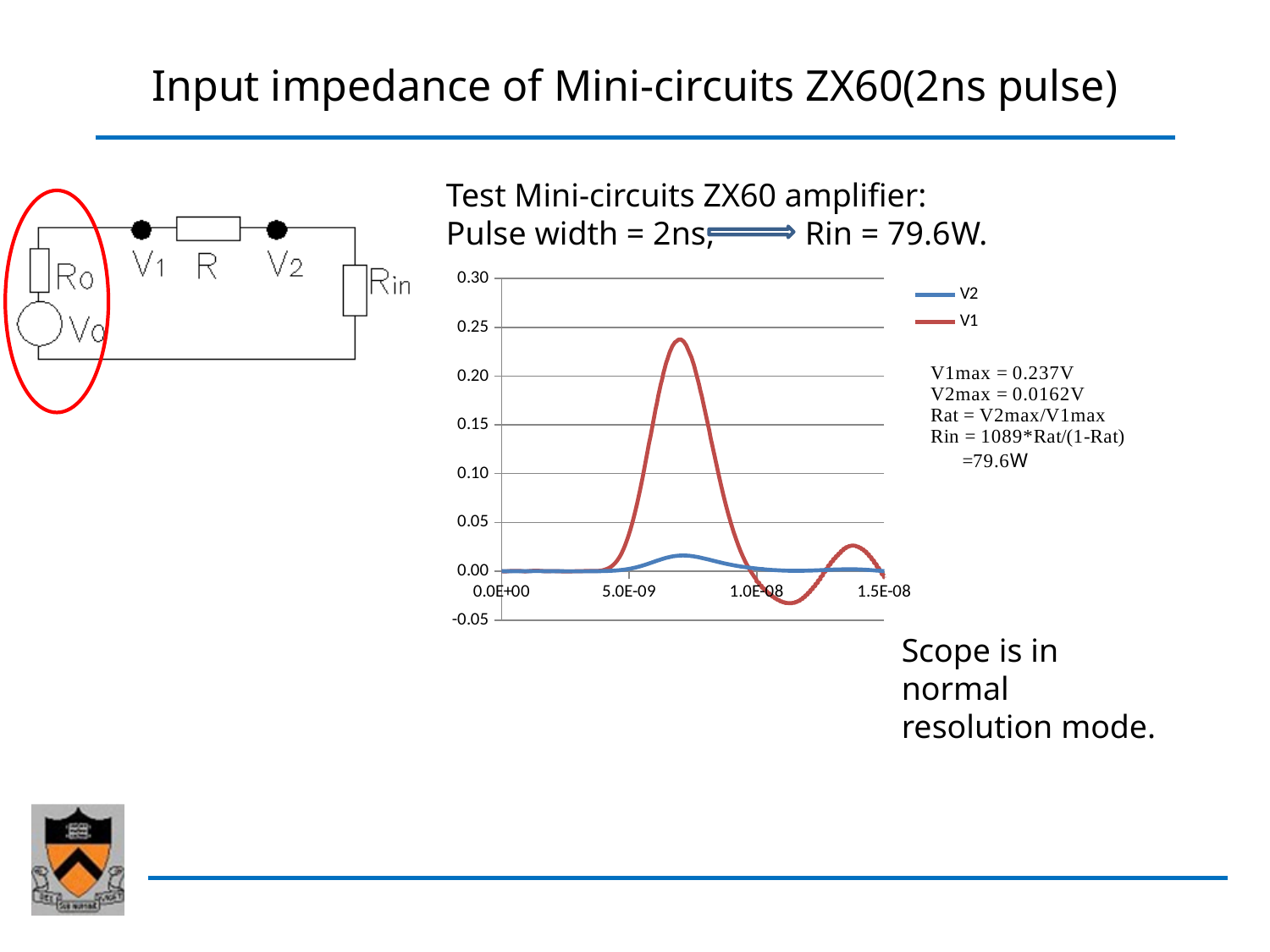
How many series does the chart legend list? 2 What type of chart is shown on the slide? line chart Which series reaches the higher peak value, V1 or V2? V1 Is the peak value of V1 greater or less than 0.20? greater According to the text beside the chart, what is V2max? 0.0162V According to the text beside the chart, what is V1max? 0.237V Which series is drawn in red on the chart? V1 Does the V1 curve dip below 0.00 after its main peak? yes What is the highest value shown on the vertical axis of the chart? 0.30 What are the names of the two series in the chart legend? V2 and V1 Is the peak value of V2 greater or less than 0.05? less